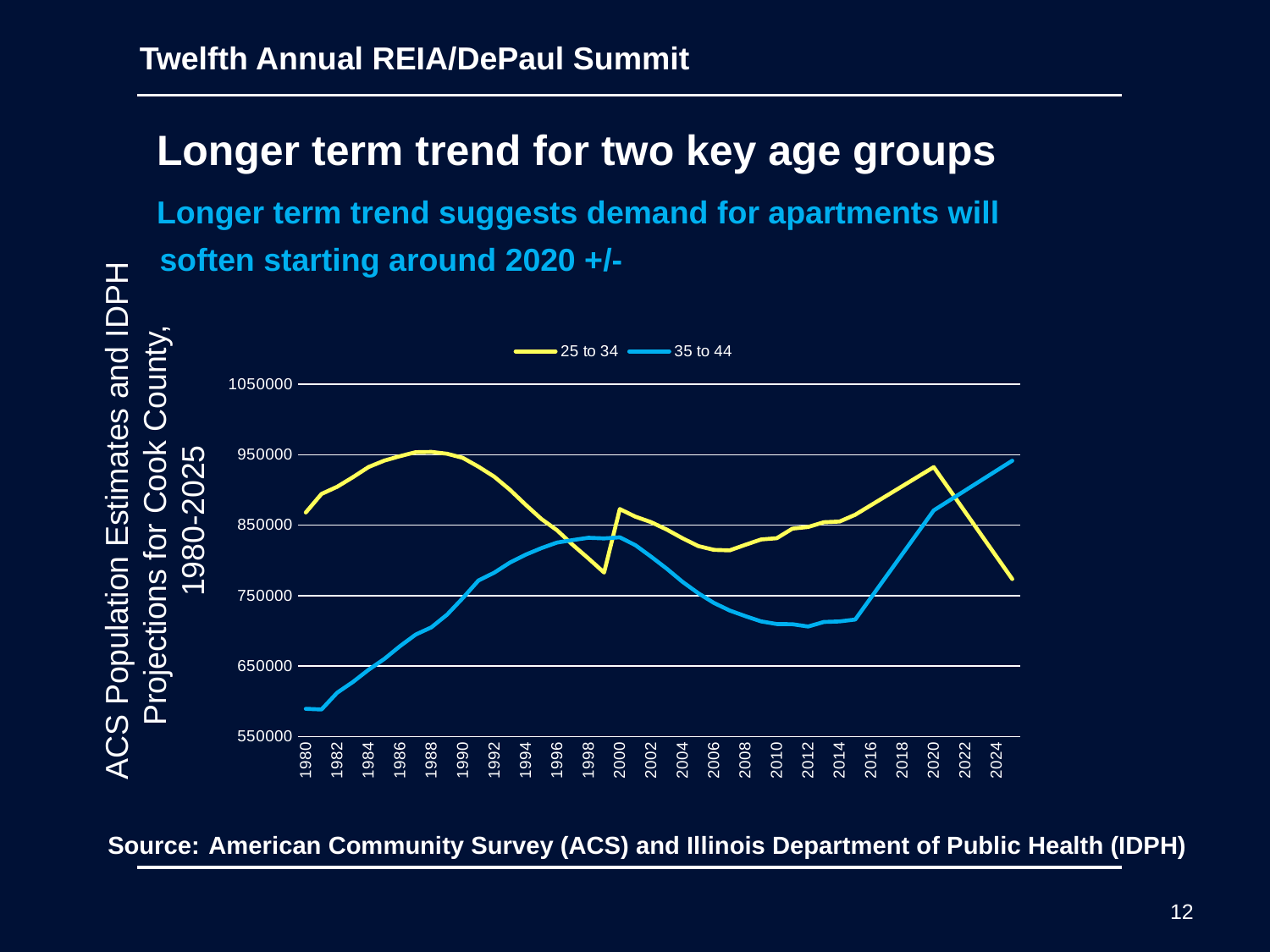
Is the value for the 35 to 44 series in 1980 greater or less than 650000? less What kind of chart is shown on the slide? line chart Is the value for the 25 to 34 series in 2024 greater or less than 850000? less Does the 35 to 44 series rise or fall between 1980 and 1998? rise Does the 25 to 34 series rise or fall between 2020 and 2024? fall What are the two series named in the legend? 25 to 34 and 35 to 44 How many series does the legend list? 2 Which colour is used for the 35 to 44 series? blue In 2024, which series has the larger value, 25 to 34 or 35 to 44? 35 to 44 Is the value for the 35 to 44 series in 2012 greater or less than 750000? less In 1980, which series has the larger value, 25 to 34 or 35 to 44? 25 to 34